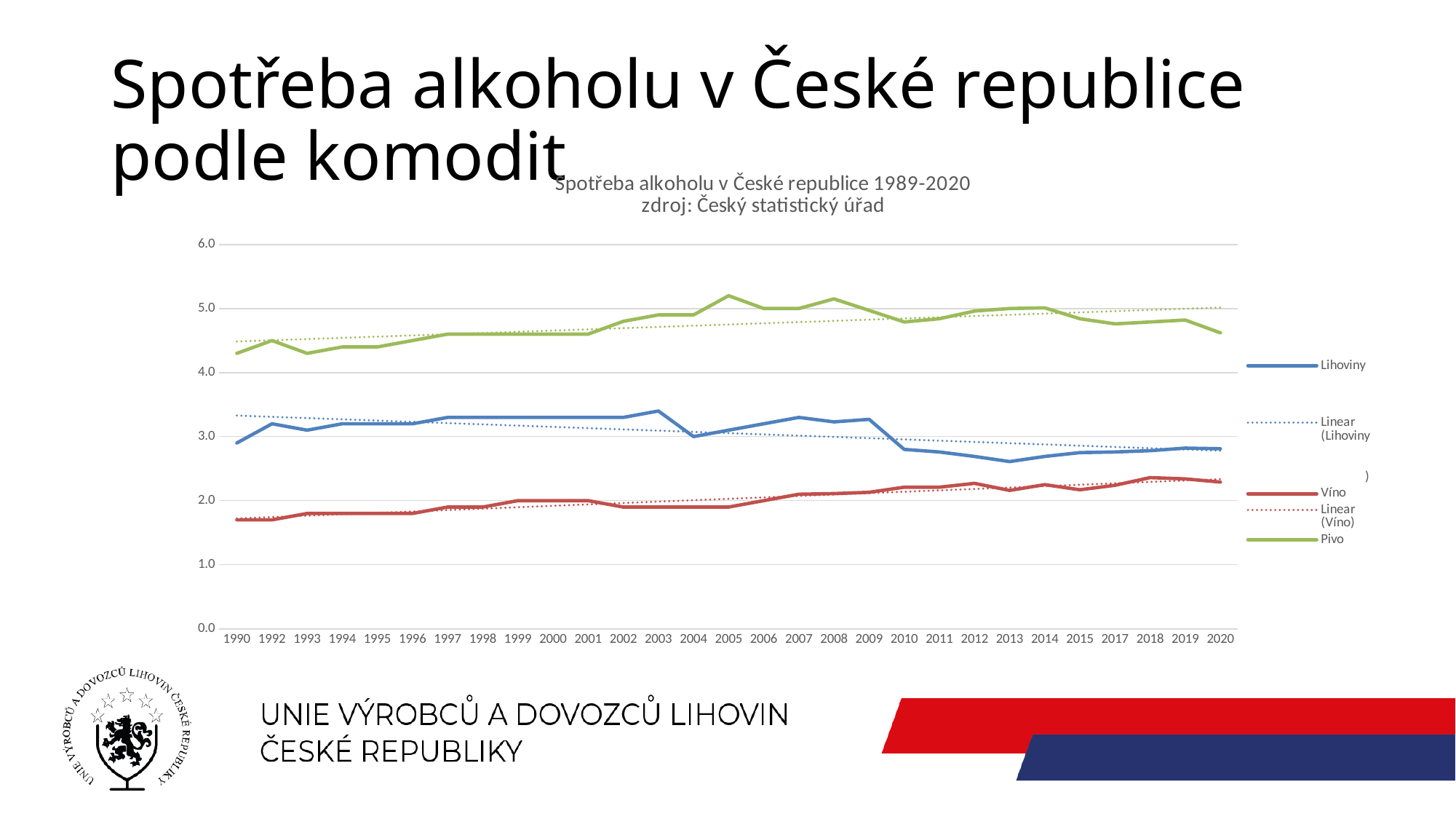
Does the Víno line generally rise or fall from 1990 to 2020? rise Is the value for Lihoviny in 2003 greater or less than 3.0? greater Is the value for Pivo in 2005 greater or less than 5.0? greater Is the value for Lihoviny in 2013 greater or less than 3.0? less What colour is the Pivo line in the chart? green Does the Lihoviny line generally rise or fall from 1990 to 2020? fall What kind of chart is shown on the slide? line chart How many entries does the chart legend list? 5 Which series has the lowest values across the whole chart? Víno Which series has the highest values across the whole chart? Pivo In 2020, which is larger: the value for Lihoviny or the value for Víno? Lihoviny